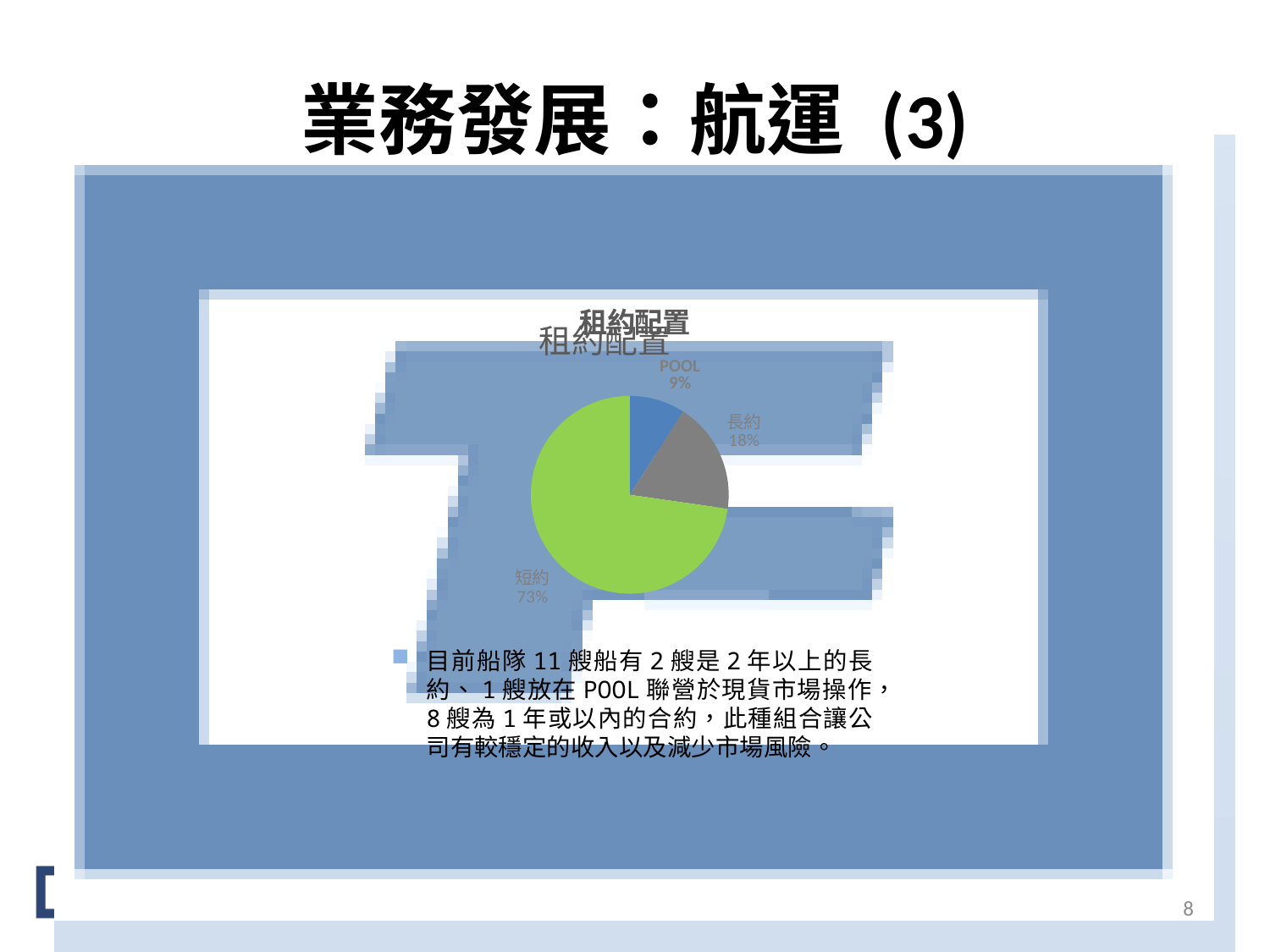
What kind of chart is shown on the slide? pie chart What colour is the 短約 slice of the pie? green How many slices does the pie chart have? 3 What share of the pie does 長約 represent? 18% What is the difference in percentage points between 長約 and POOL? 9 What is the title of the chart? 租約配置 What share of the pie does 短約 represent? 73% Which category has the largest slice of the pie? 短約 Which is larger, the share for 長約 or the share for POOL? 長約 What is the difference in percentage points between 短約 and 長約? 55 What share of the pie does POOL represent? 9% Which category has the smallest slice of the pie? POOL